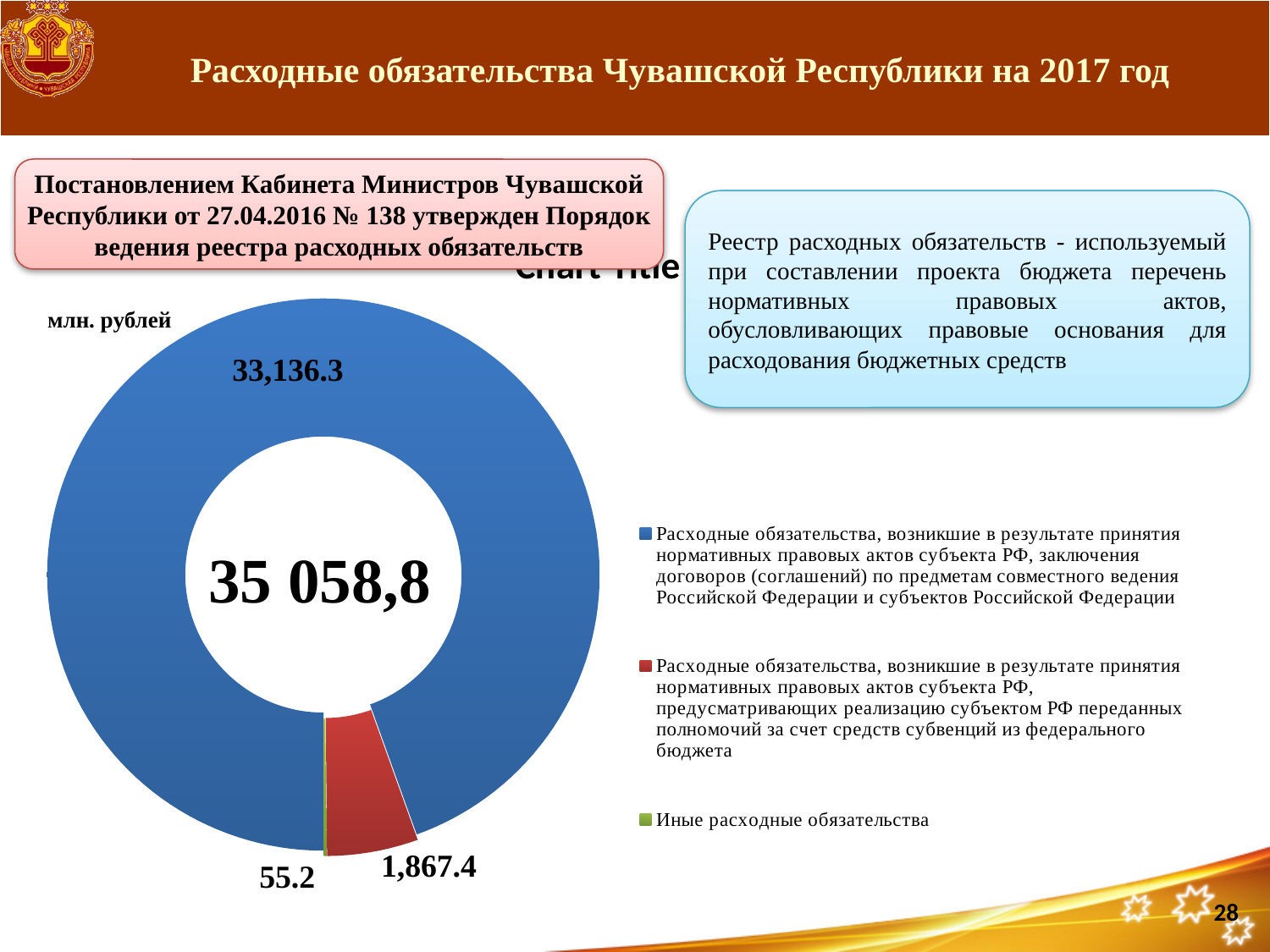
What value is shown for 'Иные расходные обязательства'? 55.2 How many entries does the chart legend list? 3 How many slices does the doughnut chart have? 3 What unit of measurement is indicated next to the chart? млн. рублей What is the difference between the blue slice value (33,136.3) and the red slice value (1,867.4)? 31,268.9 What value is shown for the largest (blue) slice of the chart? 33,136.3 What type of chart is shown on the slide? doughnut chart Which slice of the chart has the largest value? Расходные обязательства, возникшие в результате принятия нормативных правовых актов субъекта РФ, заключения договоров (соглашений) по предметам совместного ведения Which is larger: the red slice (1,867.4) or the green slice (55.2)? the red slice (1,867.4) Which slice of the chart has the smallest value? Иные расходные обязательства What total value is printed in the centre of the doughnut chart? 35 058,8 What value is shown for the red slice (обязательства за счет субвенций из федерального бюджета)? 1,867.4